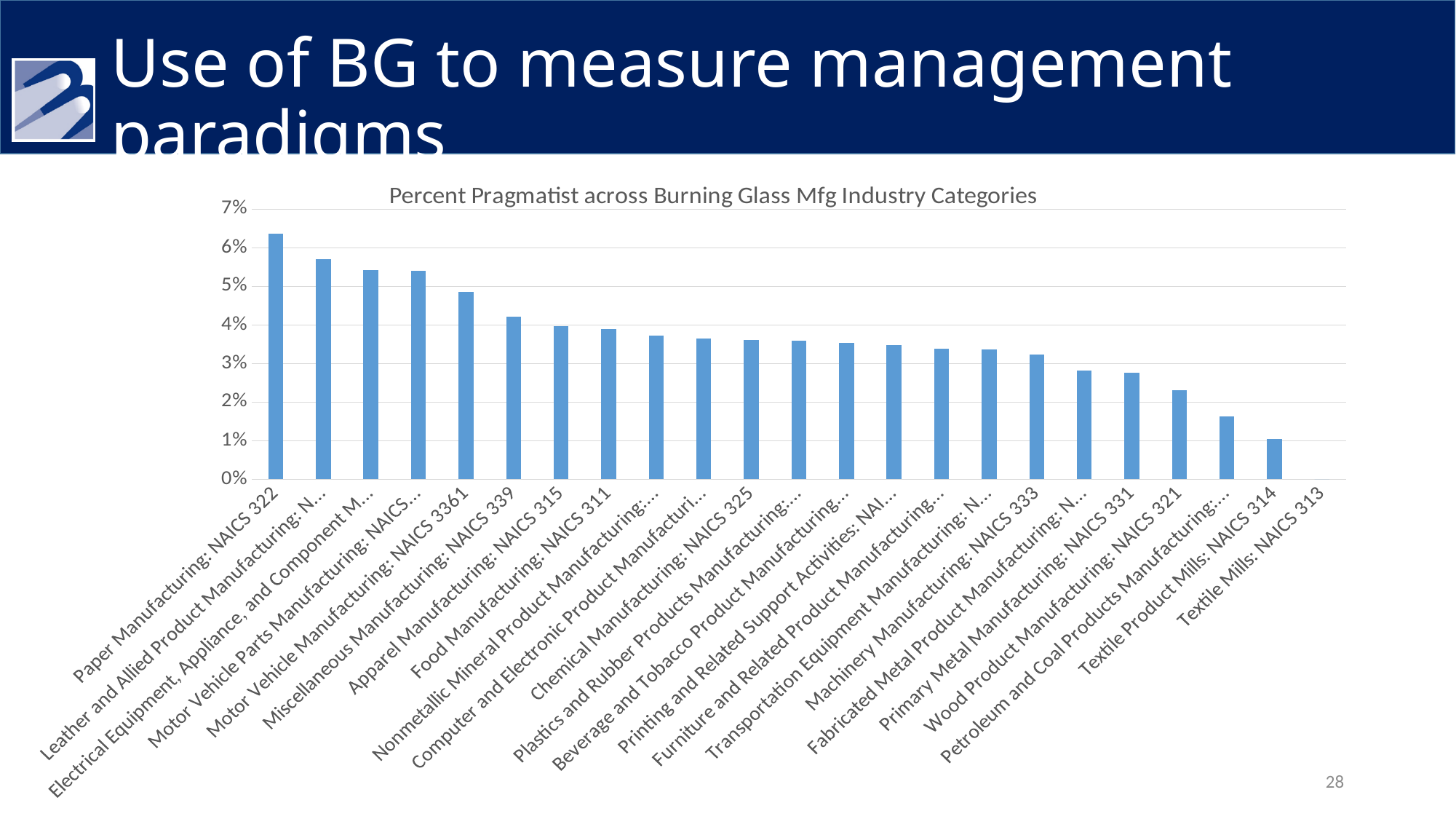
What kind of chart is shown on the slide? bar chart Is the value for Miscellaneous Manufacturing: NAICS 339 greater or less than 4%? greater Which category has the highest percent pragmatist? Paper Manufacturing: NAICS 322 Is the value for Chemical Manufacturing: NAICS 325 greater or less than 3%? greater Is the value for Motor Vehicle Manufacturing: NAICS 3361 greater or less than 5%? less Which is larger, the value for Apparel Manufacturing: NAICS 315 or Wood Product Manufacturing: NAICS 321? Apparel Manufacturing: NAICS 315 Do the values rise or fall moving from left to right along the x axis? fall Which is larger, the value for Paper Manufacturing: NAICS 322 or Food Manufacturing: NAICS 311? Paper Manufacturing: NAICS 322 What is the title of the chart? Percent Pragmatist across Burning Glass Mfg Industry Categories